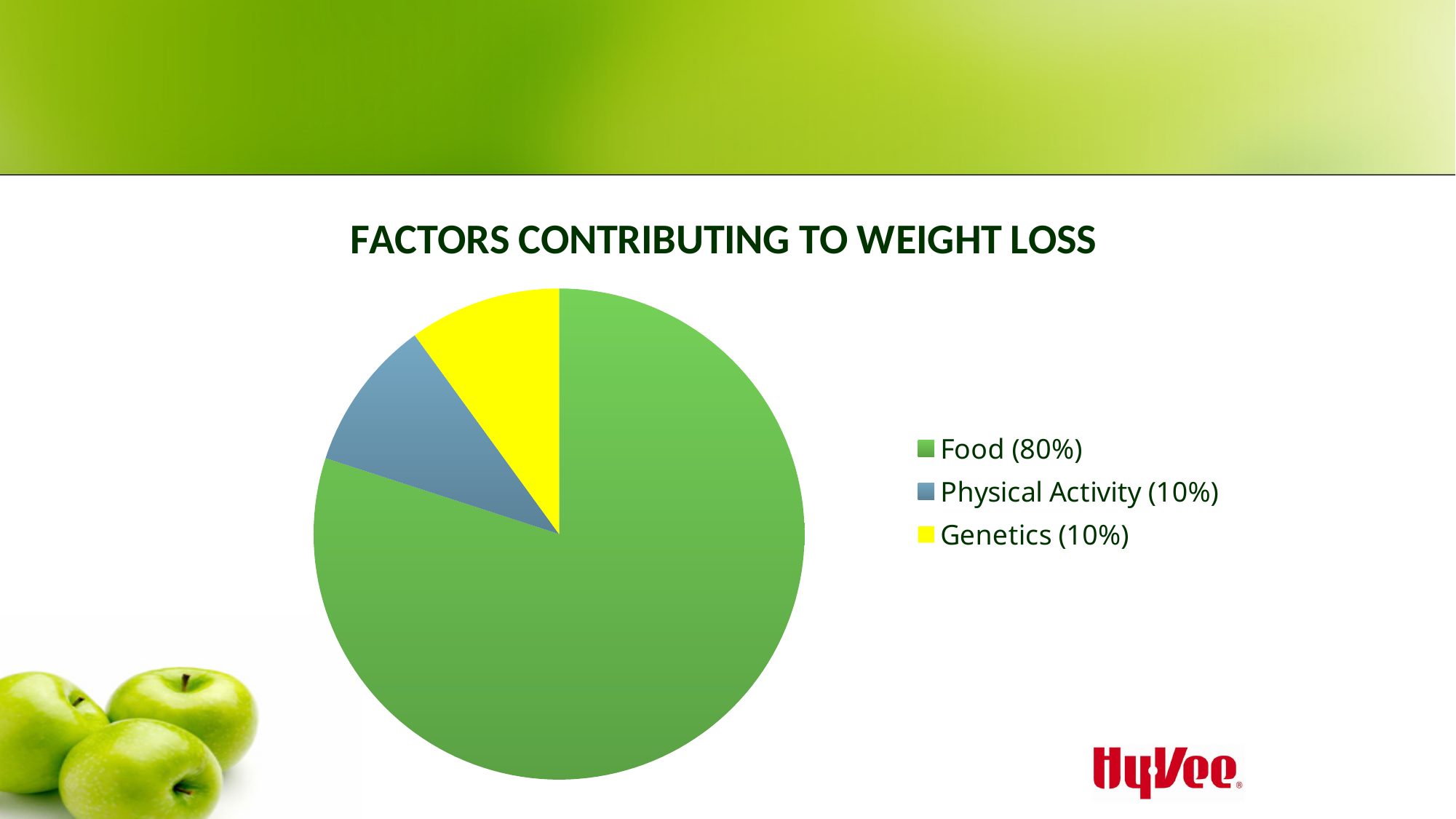
What is the combined share of Physical Activity and Genetics? 20% What colour is the Genetics slice? yellow What is the title of the chart? FACTORS CONTRIBUTING TO WEIGHT LOSS What share of the pie does Food account for? 80% Which is larger, the share for Food or the share for Physical Activity? Food What is the difference between the share for Food and the share for Genetics? 70% What type of chart is shown on the slide? pie chart What share of the pie does Physical Activity account for? 10% How many slices does the pie chart have? 3 Which factor has the largest slice of the pie? Food What share of the pie does Genetics account for? 10%